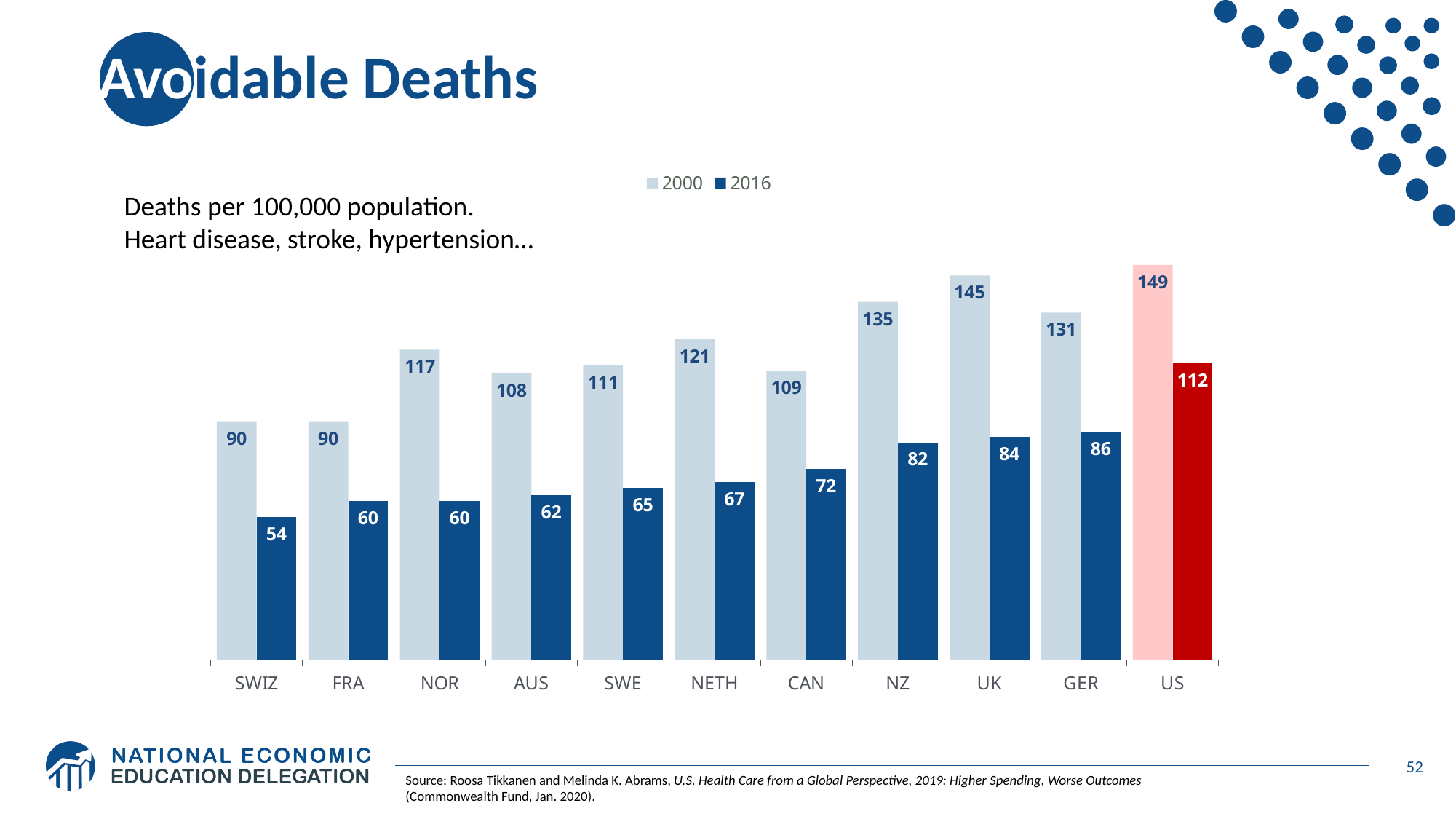
What is the difference between the US values for 2000 and 2016? 37 Which is larger: the 2016 value for Germany (GER) or the 2016 value for New Zealand (NZ)? GER Which two series are listed in the legend? 2000 and 2016 What was the value for Switzerland (SWIZ) in 2000? 90 Which country had the highest value in 2000? US What was the value for the US in 2016? 112 How many countries are shown on the x axis? 11 What was the value for the UK in 2016? 84 What kind of chart is shown on the slide? Bar chart Which country had the lowest value in 2016? SWIZ How many series does the legend list? 2 What is the difference between the 2000 and 2016 values for Norway (NOR)? 57